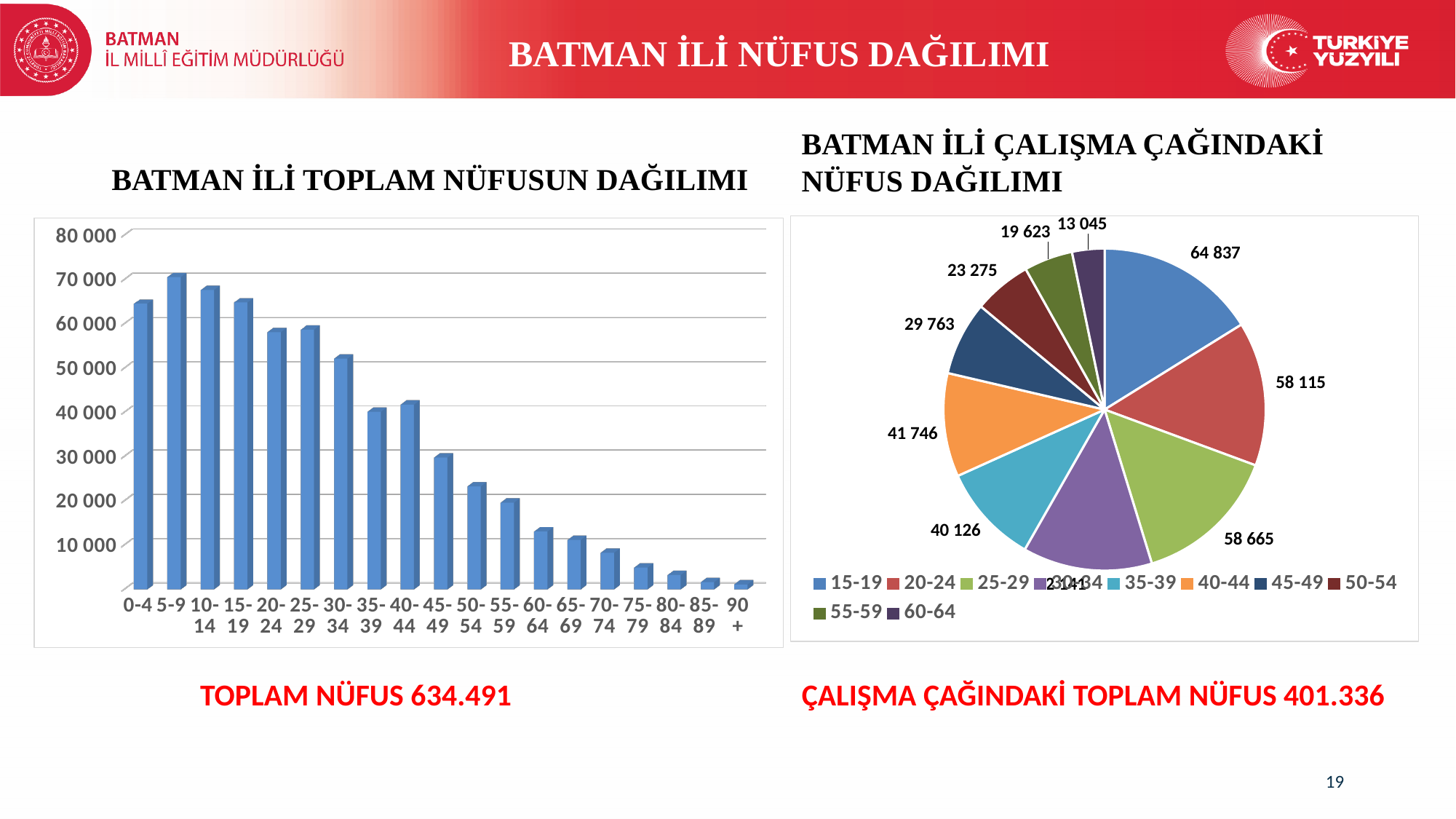
In the left bar chart, is the value for 70-74 greater or less than 10 000? less In the right pie chart, what is the difference between the 15-19 value and the 20-24 value? 6 722 In the left bar chart, how many age-group categories are shown on the x axis? 19 What kind of chart is the right chart, BATMAN İLİ ÇALIŞMA ÇAĞINDAKİ NÜFUS DAĞILIMI? pie chart In the right pie chart, which age group has the smallest slice? 60-64 In the left bar chart, which age group has the lowest value? 90+ In the left bar chart, which age group has the highest value? 5-9 In the left bar chart, do the values generally rise or fall from the 5-9 group to the 90+ group? fall In the right pie chart, how many age groups does the legend list? 10 What kind of chart is the left chart, BATMAN İLİ TOPLAM NÜFUSUN DAĞILIMI? bar chart In the left bar chart, is the value for 0-4 greater or less than 60 000? greater In the right pie chart, what is the value for the 15-19 age group? 64 837